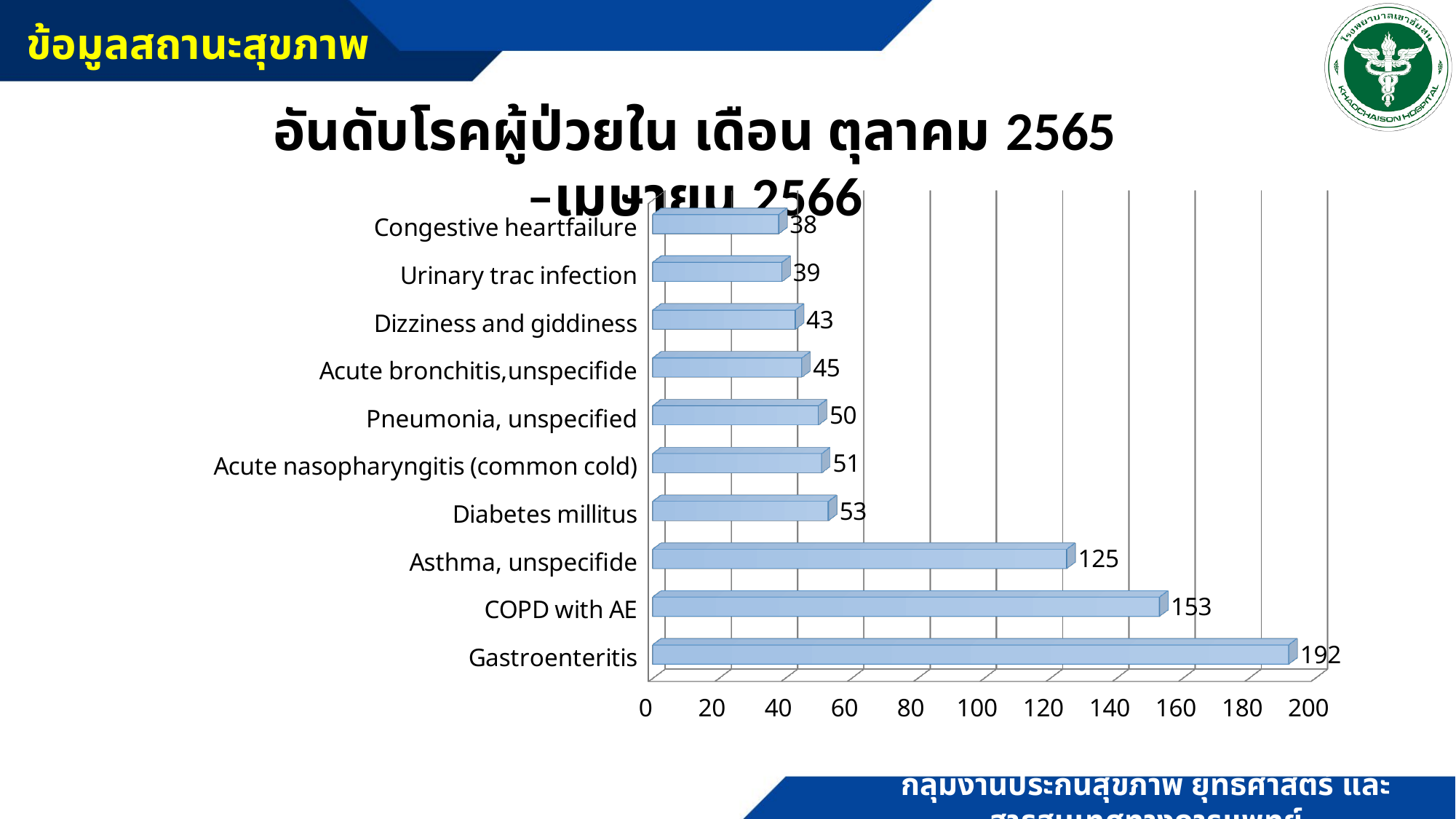
Which category has the highest value? Gastroenteritis What is the value for Congestive heartfailure? 38 Which is larger, the value for Asthma, unspecifide or the value for Diabetes millitus? Asthma, unspecifide What kind of chart is shown on the slide? Bar chart What is the value for Asthma, unspecifide? 125 What is the difference between the values for Pneumonia, unspecified and Urinary trac infection? 11 What is the difference between the values for Gastroenteritis and COPD with AE? 39 How many categories are shown in the chart? 10 Which category has the lowest value? Congestive heartfailure What is the value for COPD with AE? 153 What is the value for Gastroenteritis? 192 What is the value for Diabetes millitus? 53